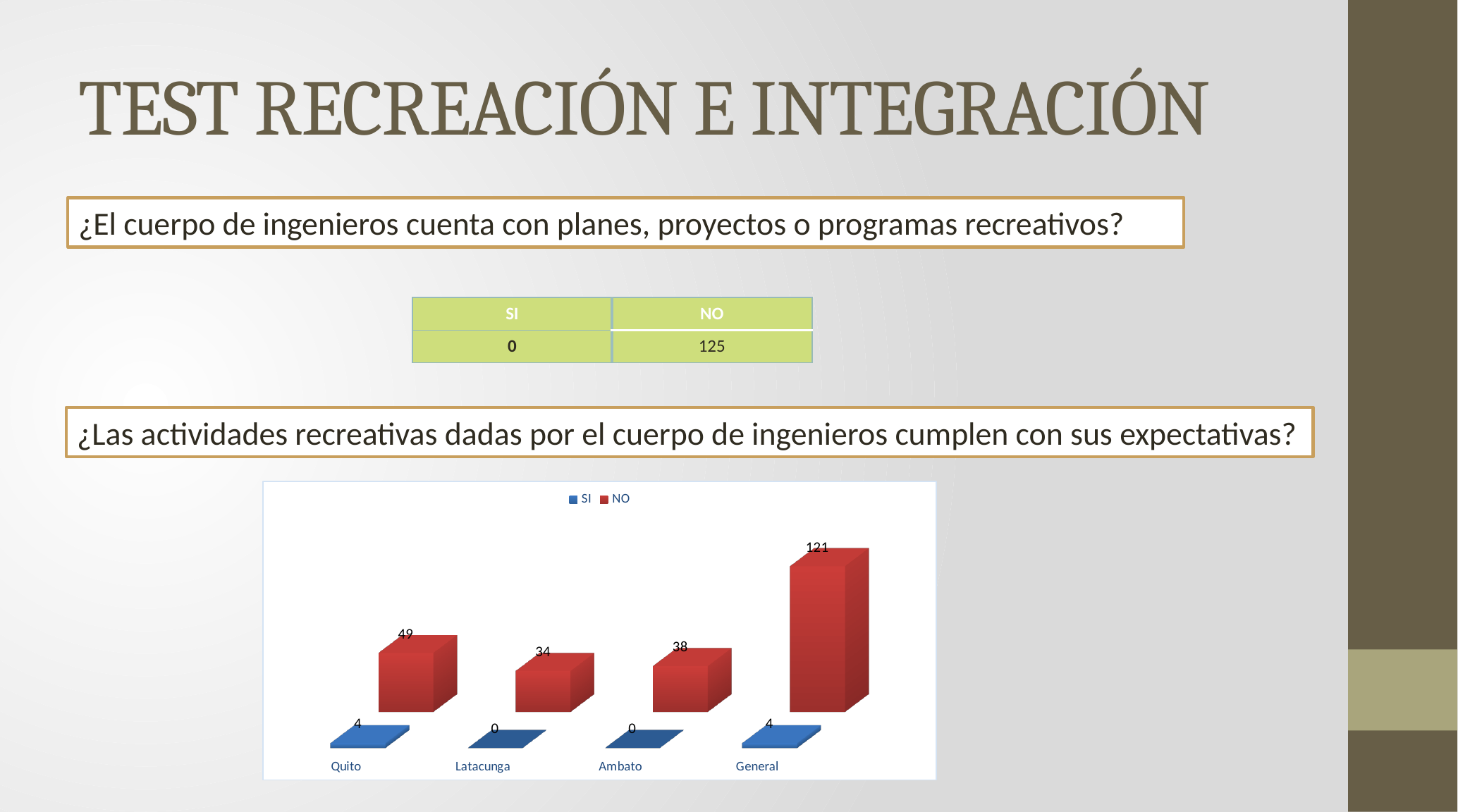
What is the NO value for General? 121 Which is larger, the NO value for Ambato or for Latacunga? Ambato What is the SI value for Latacunga? 0 Which category has the highest NO value? General How many series does the chart legend list? 2 How many categories are shown on the x axis of the chart? 4 Which category has the lowest NO value? Latacunga What is the NO value for Latacunga? 34 What is the NO value for Quito? 49 What is the difference between the NO values for General and Quito? 72 What is the SI value for Quito? 4 What is the NO value for Ambato? 38